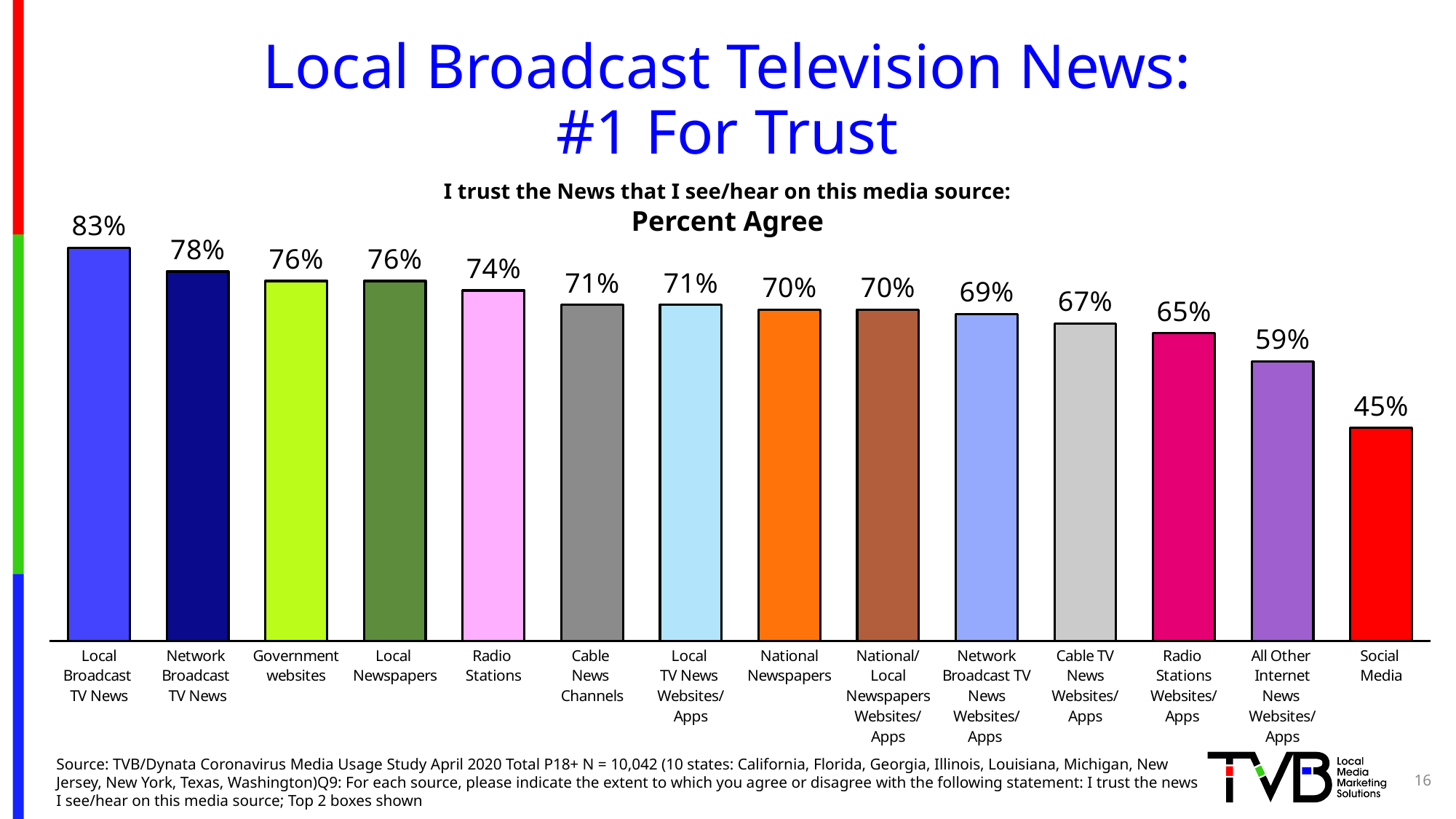
What is the percent agree value for Social Media? 45% Which media source has the highest percent agree for trust? Local Broadcast TV News Which media source has the lowest percent agree for trust? Social Media What percent agree that they trust the news on Local Broadcast TV News? 83% What is the percent agree value for Cable TV News Websites/Apps? 67% What type of chart is shown on the slide? Bar chart What is the difference in percent agree between Local Broadcast TV News and Network Broadcast TV News? 5% What is the percent agree value for Radio Stations? 74% How many media sources are shown in the chart? 14 What is the difference in percent agree between Local Broadcast TV News and Social Media? 38% Do the values generally rise or fall moving from left to right across the chart? Fall Which has a higher percent agree: Government websites or All Other Internet News Websites/Apps? Government websites